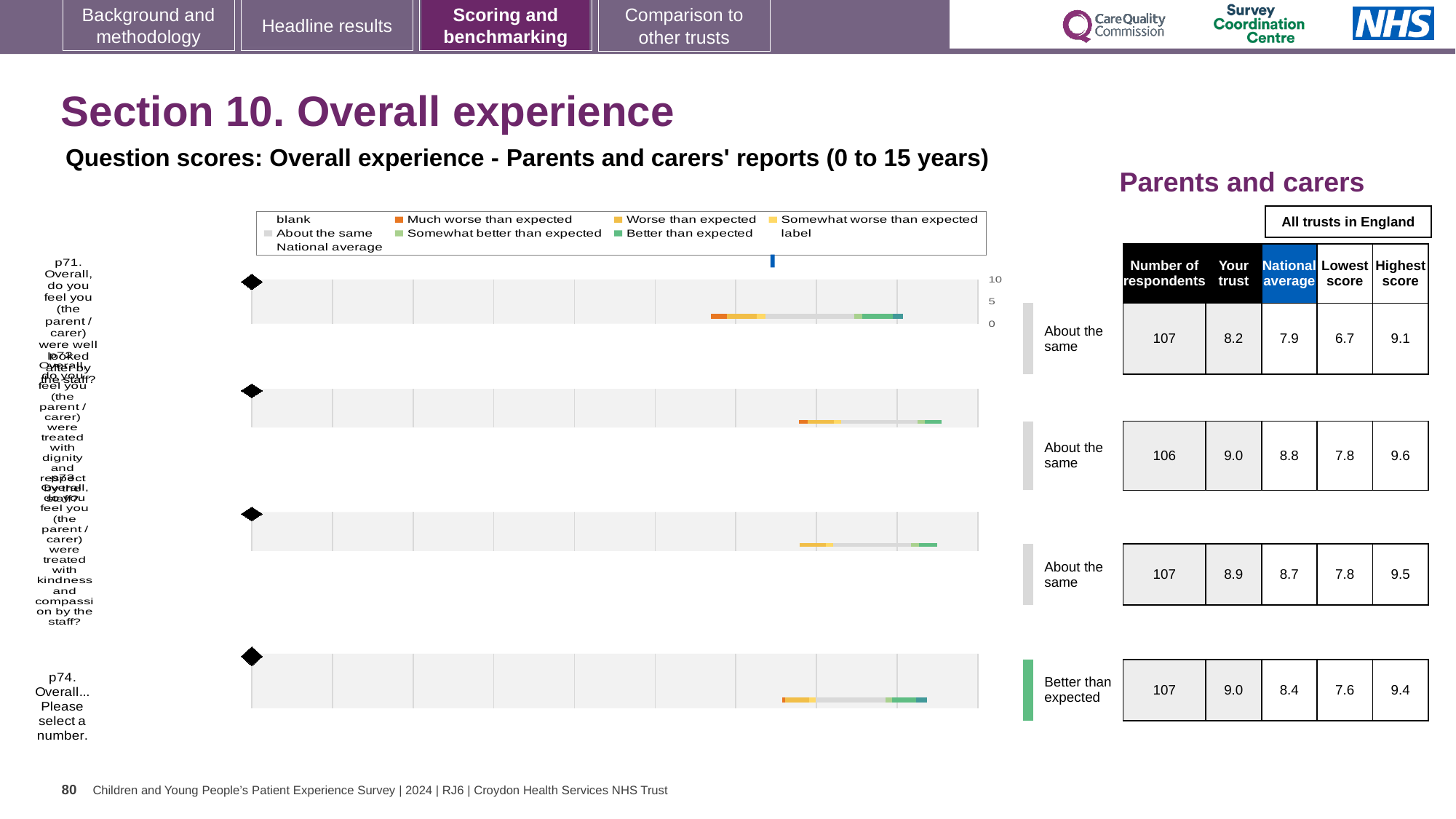
In the table, what is the 'Your trust' score for the bottom row (p74. Overall... Please select a number)? 9.0 In the table, what is the National average for the top row (p71)? 7.9 In the table, what is the Highest score for the second row (p72)? 9.6 For the top row (p71), which is larger: the 'Your trust' score or the National average? Your trust What kind of chart is shown on the slide? bar chart Which question has the lowest 'Your trust' score in the table? p71 How many questions (bars) are plotted in the chart? 4 How many entries does the chart legend list? 9 Which question is rated 'Better than expected' rather than 'About the same'? p74 For the bottom row (p74), what is the difference between the 'Your trust' score and the National average? 0.6 In the table, what is the Lowest score for the bottom row (p74)? 7.6 In the table, how many respondents are listed for the bottom row (p74)? 107